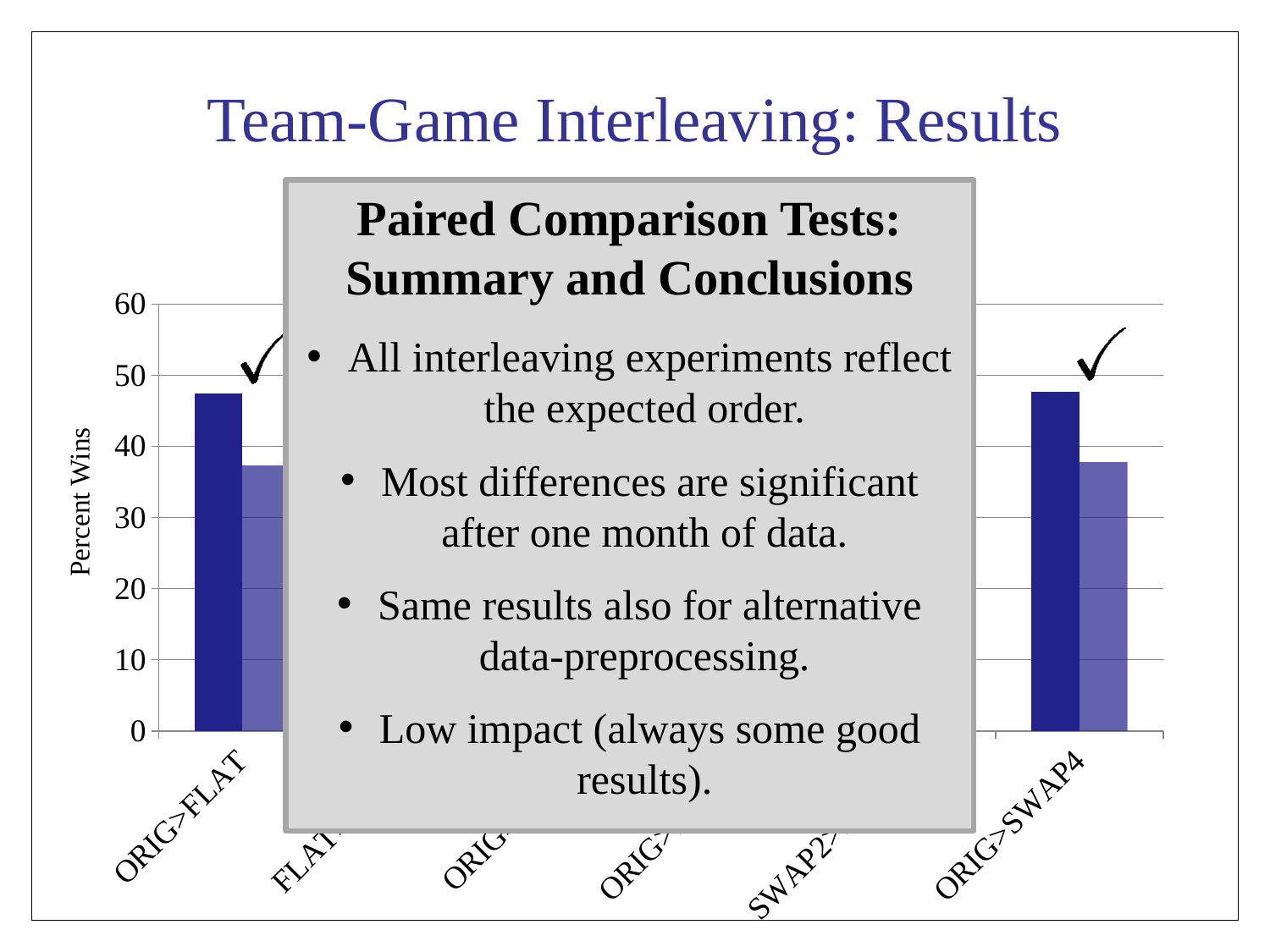
What is the highest value shown on the vertical axis of the chart? 60 Is the value of the dark blue bar for ORIG>SWAP4 greater or less than 40? greater For ORIG>SWAP4, which bar is taller, the dark blue bar or the light blue bar? the dark blue bar Is the value of the light blue bar for ORIG>FLAT greater or less than 40? less Is the value of the light blue bar for ORIG>SWAP4 greater or less than 40? less What kind of chart is shown on the slide? bar chart What is the label of the vertical axis of the chart? Percent Wins For ORIG>FLAT, which bar is taller, the dark blue bar or the light blue bar? the dark blue bar How many bars are plotted for each category on the x axis? 2